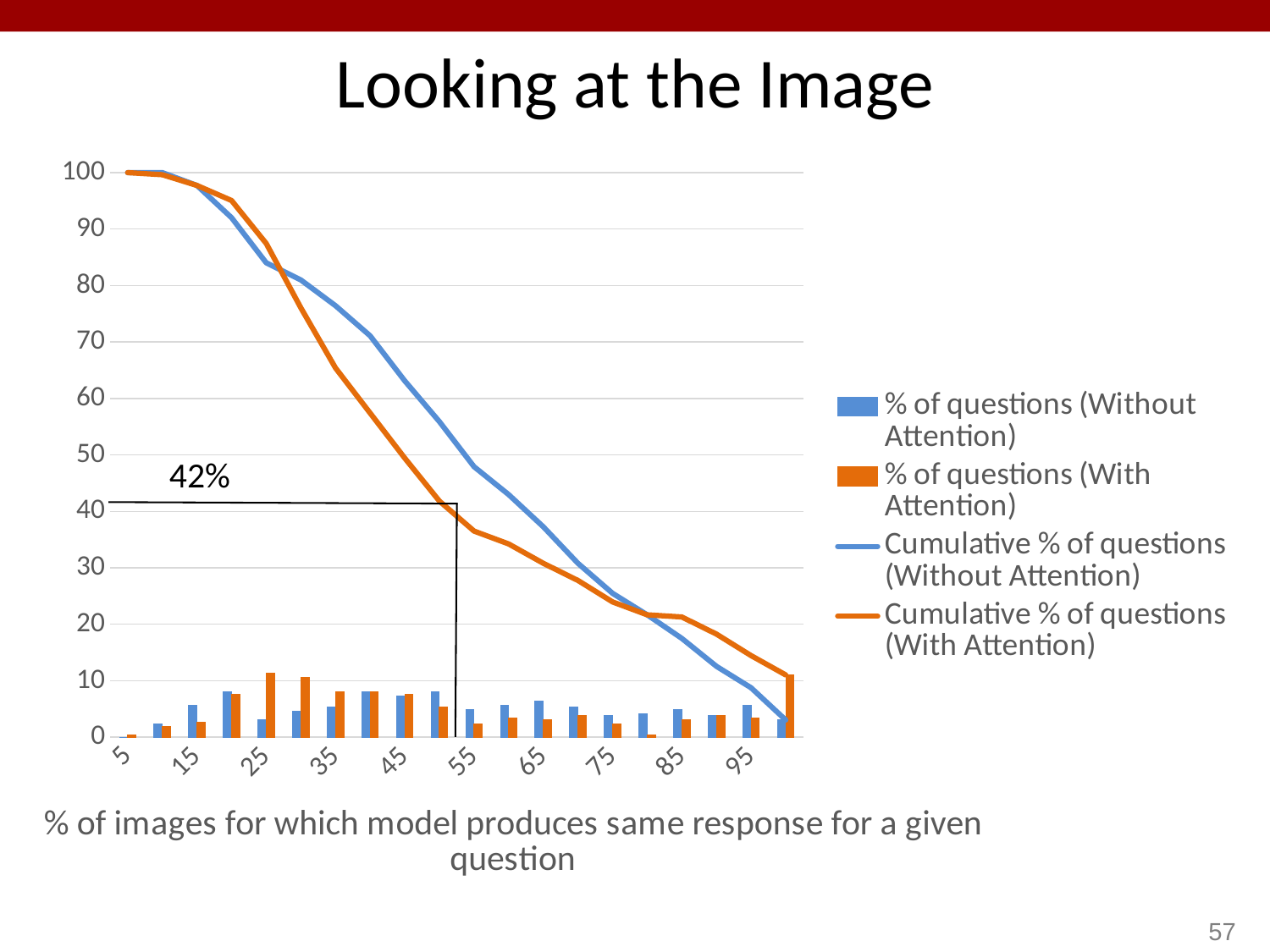
Is the Cumulative % of questions (With Attention) value at 95 greater or less than 10? greater What value is annotated with a callout on the chart? 42% Do the cumulative % of questions lines rise or fall as the x-axis values increase? Fall Is the Cumulative % of questions (Without Attention) value at 95 greater or less than 10? less What kind of chart is shown on the slide? A combined bar and line chart At which x-axis value is the % of questions (With Attention) bar the tallest? 25 How many labelled tick marks are shown on the x axis? 10 How many series does the legend list? 4 What is the title of the slide containing the chart? Looking at the Image At 45 on the x axis, which cumulative line is higher: Without Attention or With Attention? Without Attention Is the Cumulative % of questions (Without Attention) value at 25 greater or less than 80? greater